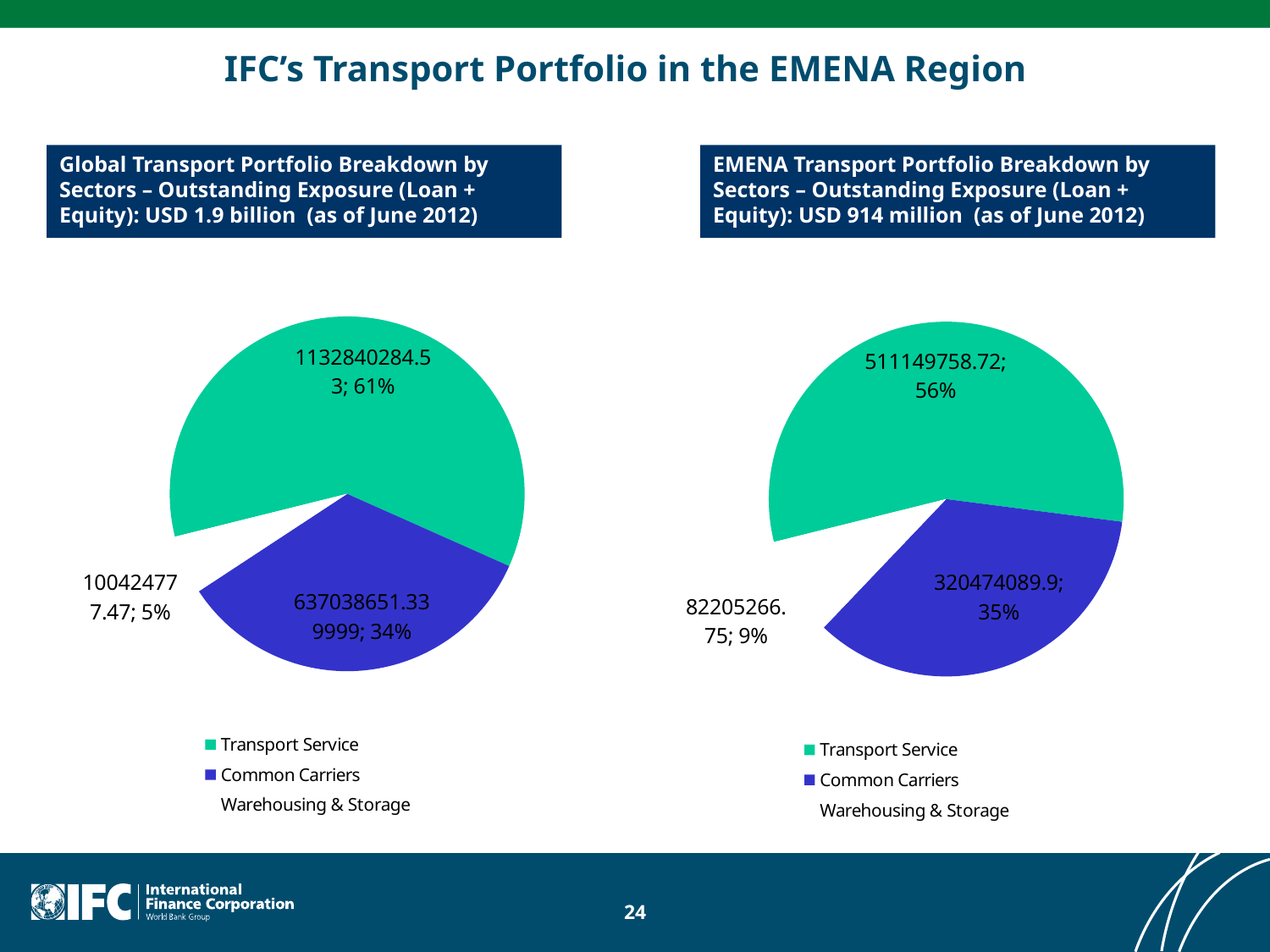
In the Global Transport Portfolio chart on the left, what is the difference in percentage points between Transport Service and Common Carriers? 27 percentage points In the EMENA Transport Portfolio chart on the right, what is the value shown for Transport Service? 511149758.72 In the Global Transport Portfolio chart on the left, what share of the pie does Transport Service hold? 61% In the EMENA Transport Portfolio chart on the right, what percentage is shown for Warehousing & Storage? 9% In the Global Transport Portfolio chart on the left, what percentage is shown for Warehousing & Storage? 5% According to the title of the chart on the right, what is the total outstanding exposure of the EMENA transport portfolio? USD 914 million How many sectors does the legend of the EMENA Transport Portfolio chart on the right list? 3 In the EMENA Transport Portfolio chart on the right, what share of the pie does Common Carriers hold? 35% What type of chart is used for the Global Transport Portfolio breakdown on the left? Pie chart In the Global Transport Portfolio chart on the left, which sector has the smallest share? Warehousing & Storage In the EMENA Transport Portfolio chart on the right, which sector has the largest share? Transport Service In the EMENA Transport Portfolio chart on the right, which is larger: the share for Common Carriers or the share for Warehousing & Storage? Common Carriers